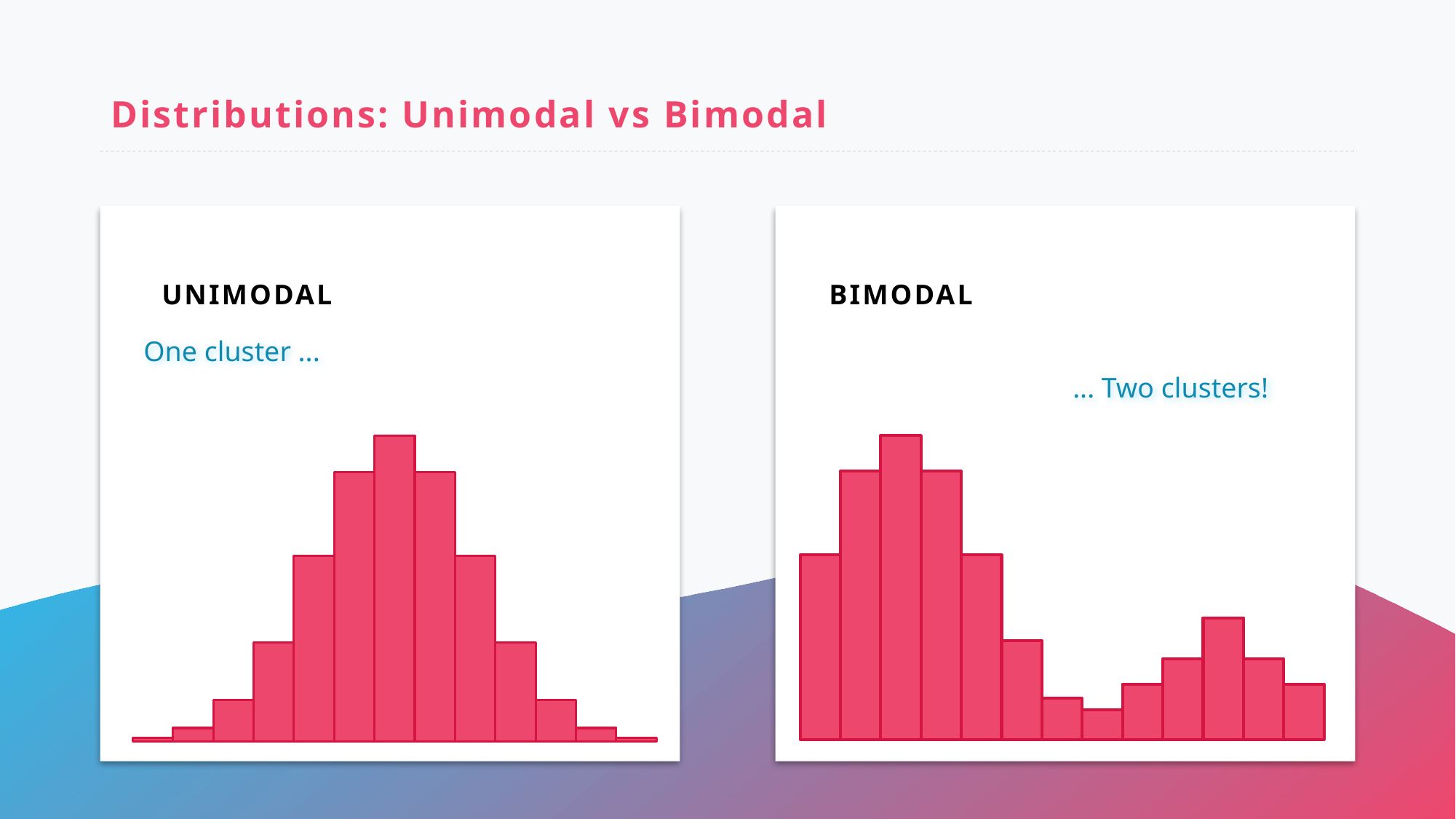
How many peaks (clusters) does the BIMODAL chart show? 2 In the UNIMODAL chart, is the tallest bar located at the left edge, the centre, or the right edge of the chart? the centre In the BIMODAL chart, is the tallest bar of the left cluster taller or shorter than the tallest bar of the right cluster? taller In the UNIMODAL chart, do the bars rise or fall from the left edge toward the centre? rise In the BIMODAL chart, do the bars rise or fall from the third bar to the eighth bar? fall How many bars are plotted in the BIMODAL chart? 13 What kind of chart is shown in the UNIMODAL panel? bar chart In the BIMODAL chart, which bar from the left is the tallest? the third bar In the BIMODAL chart, do the bars rise or fall from the first bar to the third bar? rise What kind of chart is shown in the BIMODAL panel? bar chart What colour are the bars in both charts? pink/red